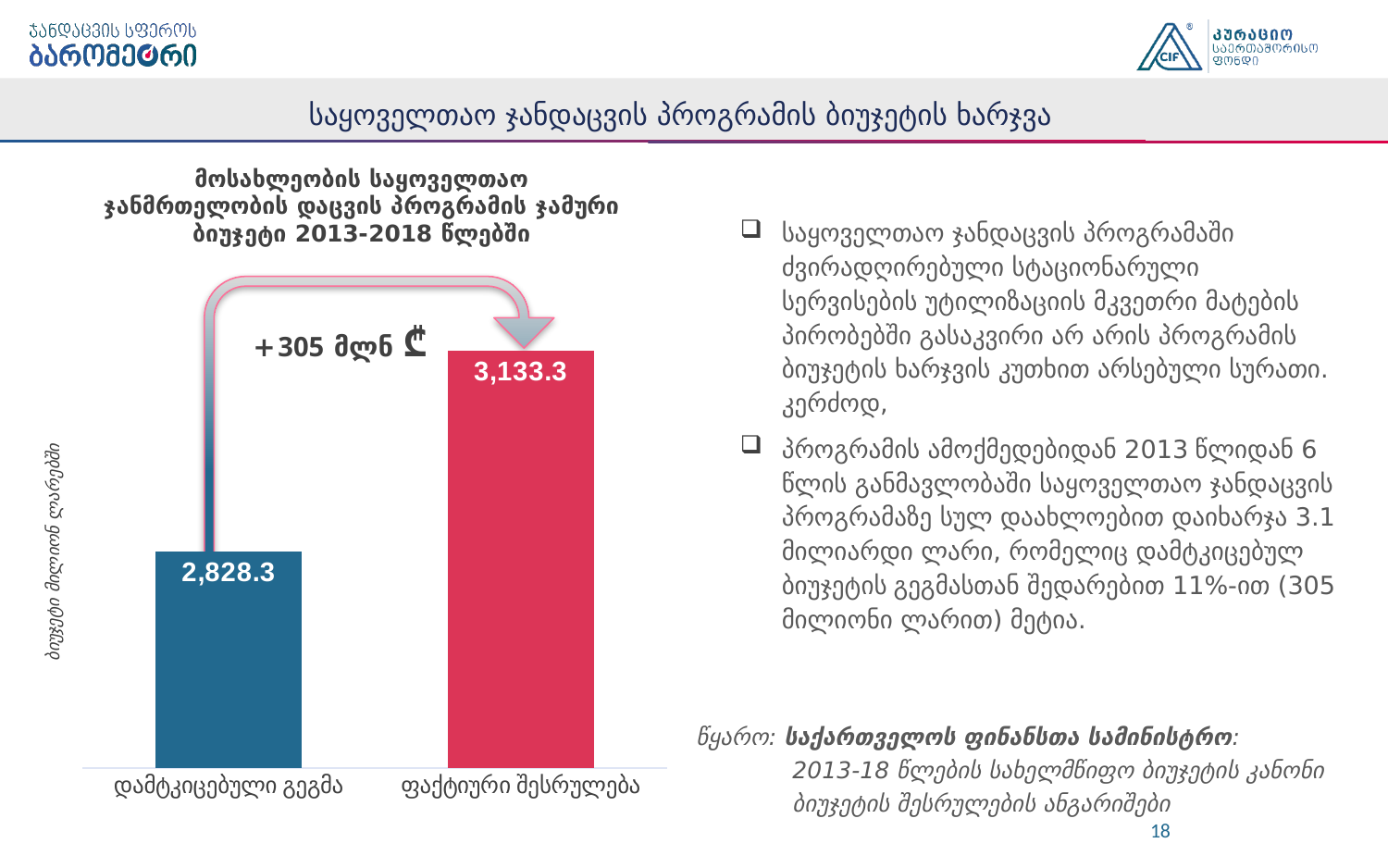
Which is larger, the value for დამტკიცებული გეგმა or the value for ფაქტიური შესრულება? ფაქტიური შესრულება What is the value for ფაქტიური შესრულება? 3,133.3 What is the difference between the values for ფაქტიური შესრულება and დამტკიცებული გეგმა? 305 What is the value for დამტკიცებული გეგმა? 2,828.3 How many categories are shown in the chart? 2 What kind of chart is shown on the slide? bar chart Which category has the lowest value? დამტკიცებული გეგმა What is the title of the chart? მოსახლეობის საყოველთაო ჯანმრთელობის დაცვის პროგრამის ჯამური ბიუჯეტი 2013-2018 წლებში What increase is annotated between the two bars on the chart? +305 მლნ ₾ Which category has the highest value? ფაქტიური შესრულება Do the values rise or fall from left to right along the x axis? rise